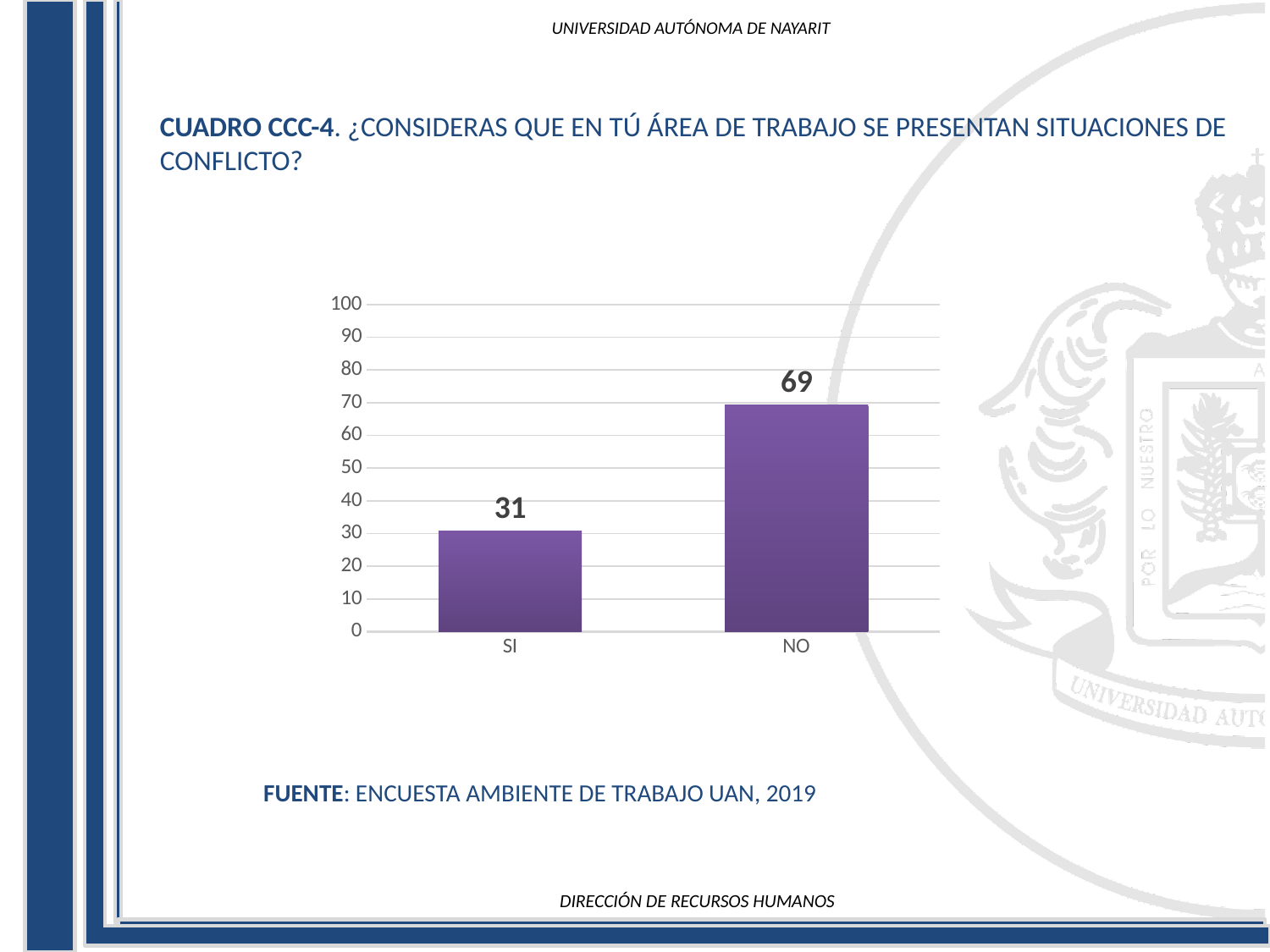
What kind of chart is shown on the slide? bar chart Which category has the highest value? NO What is the difference between the values for NO and SI? 38 What is the value for SI? 31 Is the value for SI greater or less than 40? less Which category has the lowest value? SI What is the value for NO? 69 What is the total of the two values shown in the chart? 100 How many categories are shown on the x axis? 2 Which is larger, the value for SI or the value for NO? NO What is the highest value shown on the vertical axis? 100 Is the value for NO greater or less than 60? greater